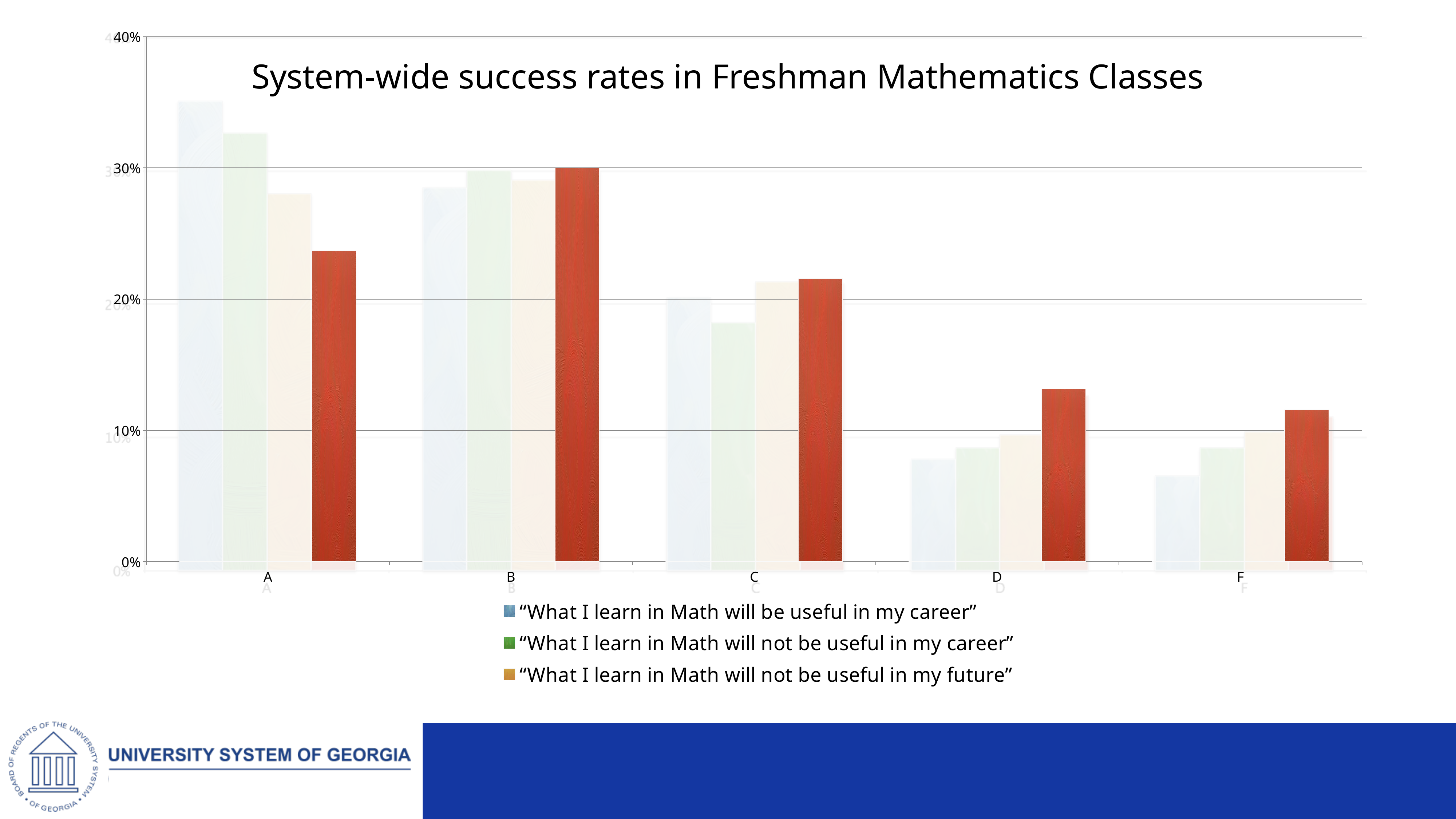
What is the title of the chart? System-wide success rates in Freshman Mathematics Classes How many categories are shown on the x axis? 5 Is the red bar for category A greater or less than 20%? greater Which category has the tallest red bar? B Which category has the shortest red bar? F How many series does the legend list? 3 Is the red bar for category D greater or less than 10%? greater Is the red bar for category C greater or less than 30%? less Is the red bar for category A larger or smaller than the red bar for category C? larger What kind of chart is shown on the slide? bar chart